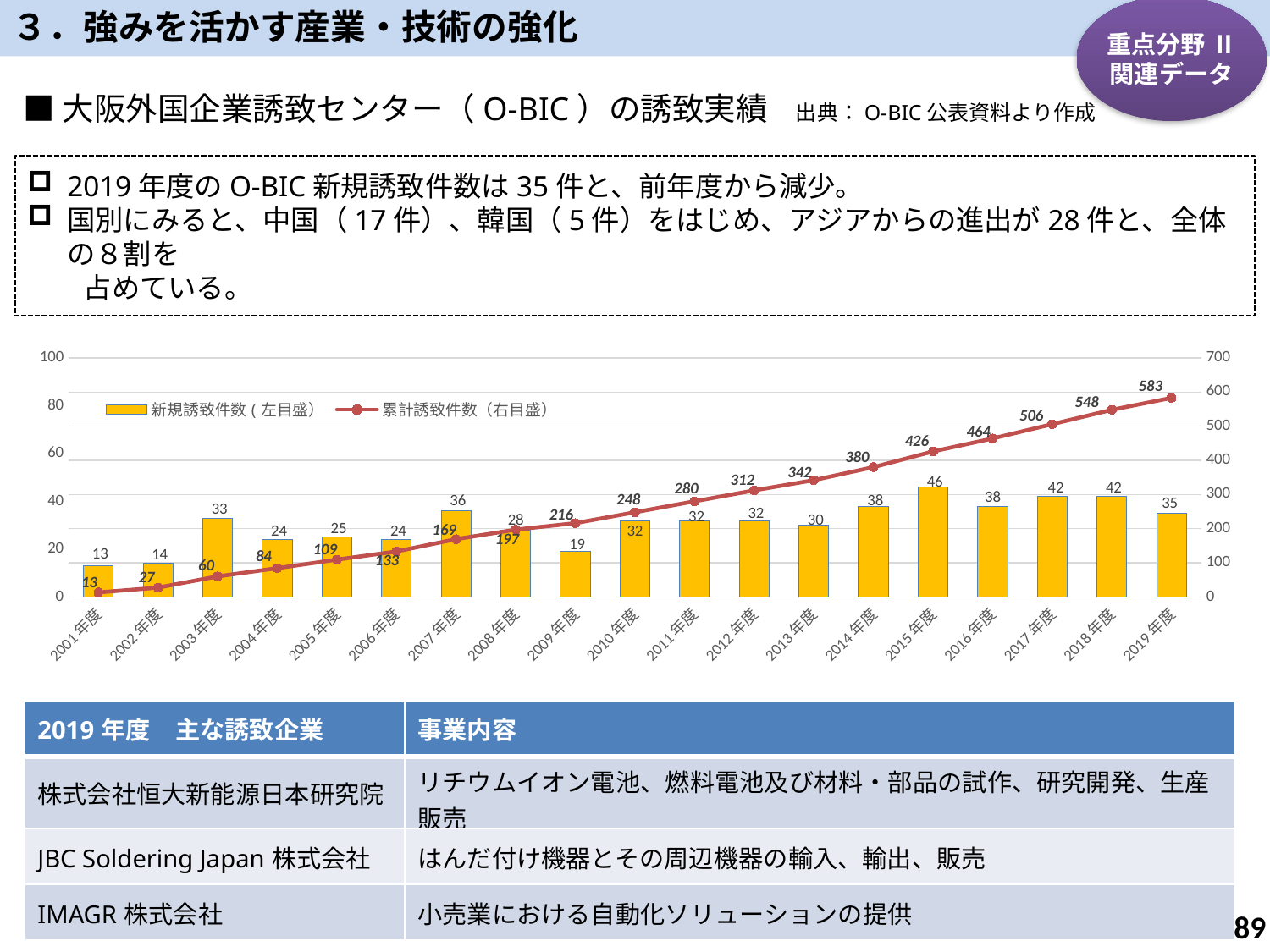
What is the value of 累計誘致件数 for 2014年度? 380 What is the value of 新規誘致件数 for 2009年度? 19 Which year has the lowest 新規誘致件数? 2001年度 Does the 累計誘致件数 line rise or fall from 2001年度 to 2019年度? rise How many years are shown on the x axis of the chart? 19 Which is larger, the 新規誘致件数 for 2007年度 or for 2008年度? 2007年度 What is the difference in 新規誘致件数 between 2018年度 and 2019年度? 7 Which series is plotted as bars in the chart? 新規誘致件数（左目盛） How many series does the chart legend list? 2 Which year has the highest 新規誘致件数? 2015年度 What is the value of 累計誘致件数 for 2019年度? 583 What is the value of 新規誘致件数 for 2019年度? 35